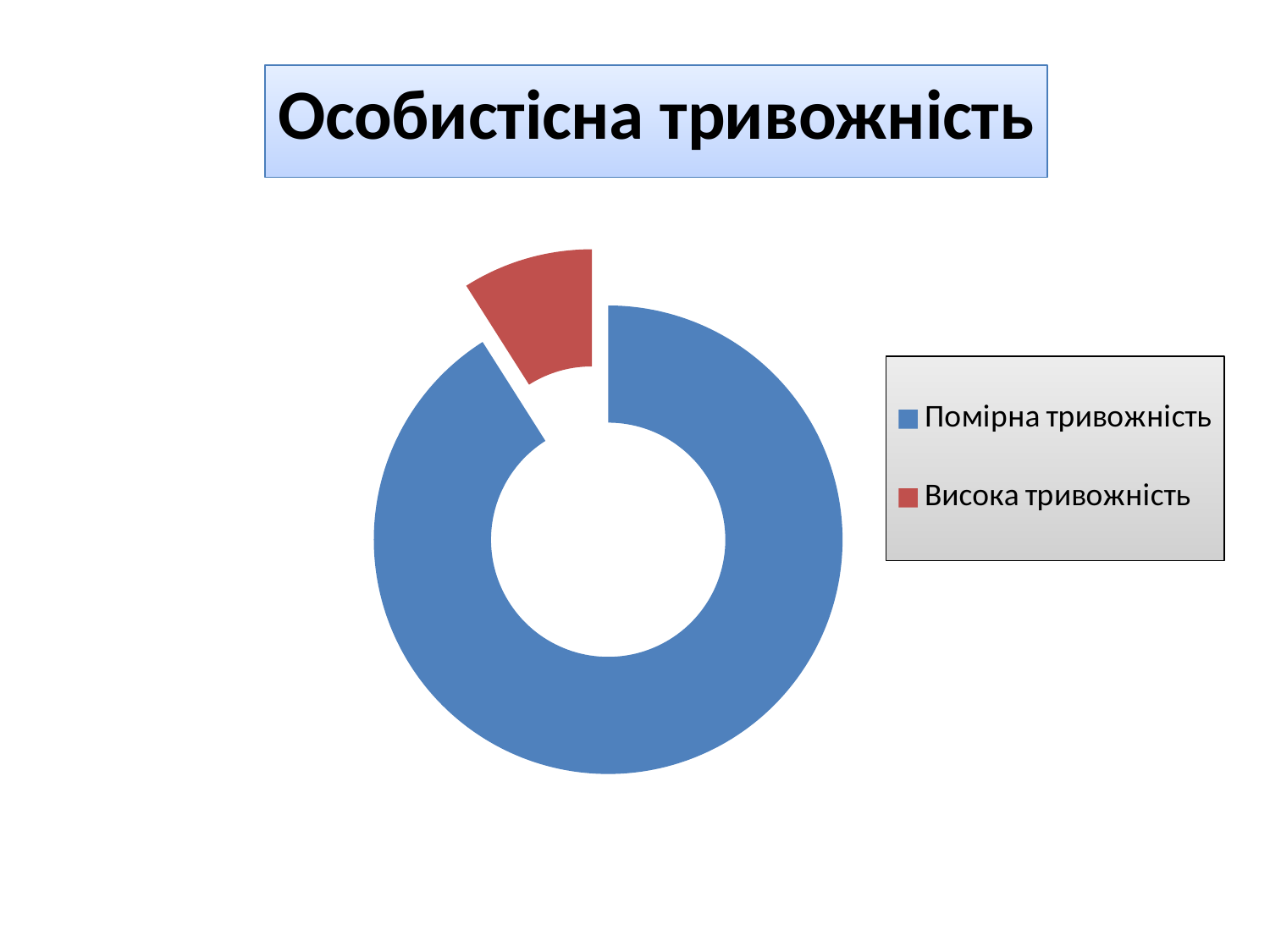
Which category has the smallest share of the chart? Висока тривожність Which is larger, the share for Помірна тривожність or the share for Висока тривожність? Помірна тривожність How many entries does the legend list? 2 Which category has the largest share of the chart? Помірна тривожність What colour represents Висока тривожність in the chart? red What kind of chart is shown on the slide? doughnut chart How many categories does the chart show? 2 What is the title of the chart? Особистісна тривожність